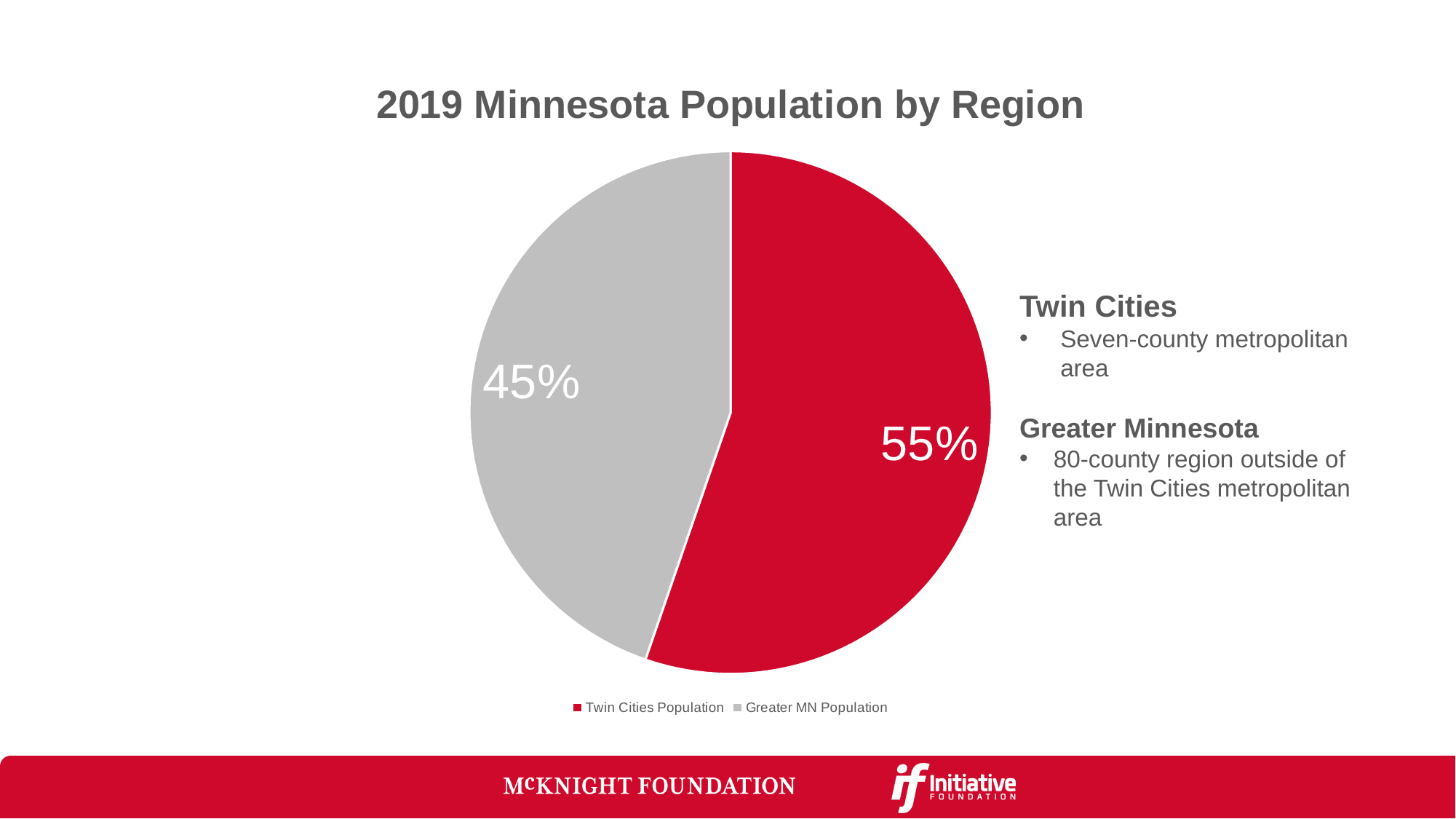
How many slices does the pie chart have? 2 What colour is the Greater MN Population slice? Grey Which is larger, Twin Cities Population or Greater MN Population? Twin Cities Population What kind of chart is shown on the slide? Pie chart What is the difference in percentage points between Twin Cities Population and Greater MN Population? 10 How many entries does the legend list? 2 Which slice is the largest? Twin Cities Population What share of the pie does Greater MN Population represent? 45% What is the title of the chart? 2019 Minnesota Population by Region Which slice is the smallest? Greater MN Population What share of the pie does Twin Cities Population represent? 55% Is the share for Twin Cities Population greater or less than 50%? greater